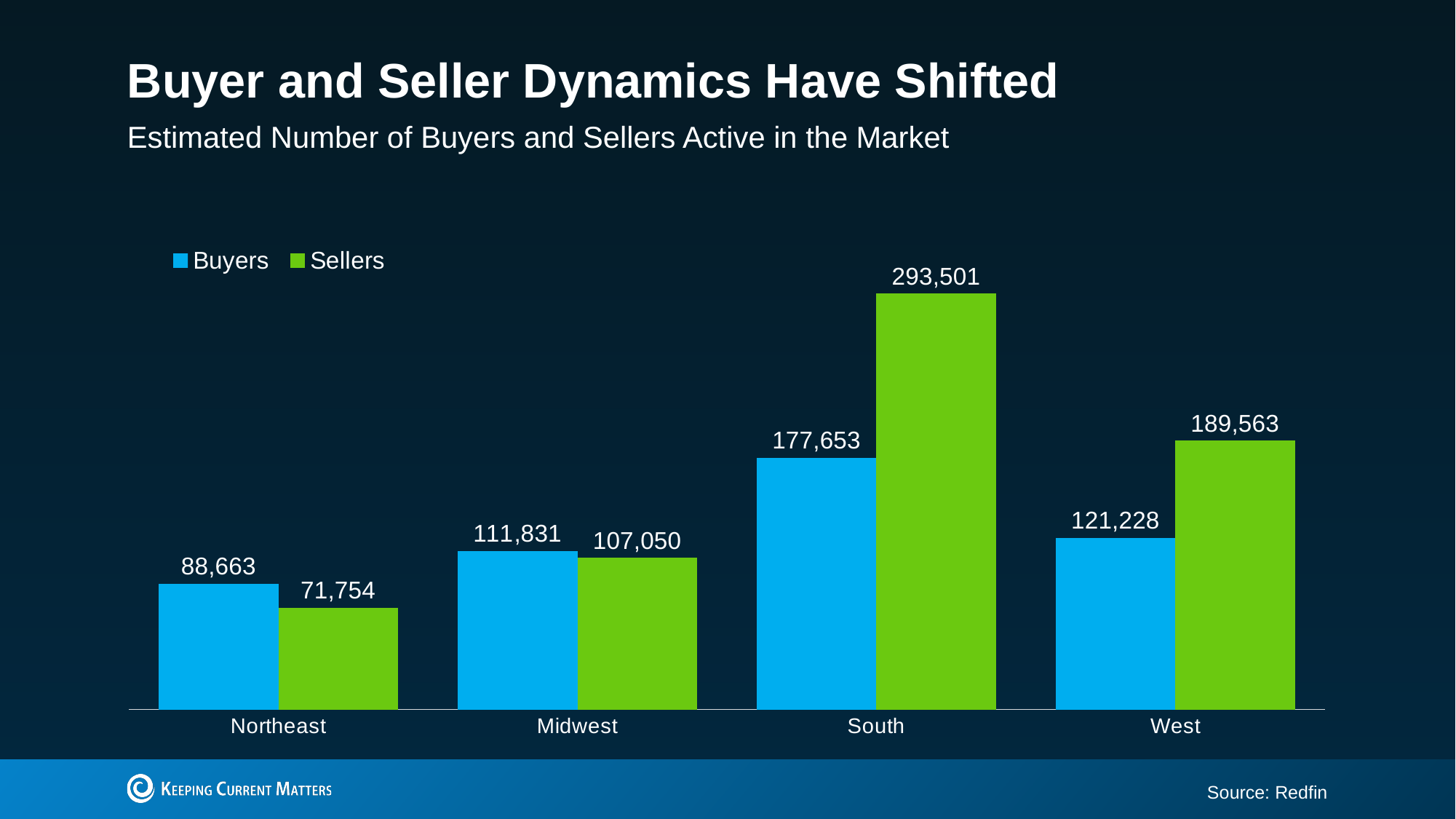
What is the number of Sellers in the Northeast? 71,754 What is the number of Sellers in the West? 189,563 In the Midwest, are there more Buyers or Sellers? Buyers How many regions are shown on the x axis? 4 What is the difference between Sellers and Buyers in the South? 115,848 What kind of chart is shown on the slide? Bar chart What is the difference between Buyers and Sellers in the Northeast? 16,909 How many series does the legend list? 2 What is the number of Buyers in the South? 177,653 Which region has the highest number of Sellers? South What colour represents Sellers in the chart? Green Which region has the lowest number of Buyers? Northeast